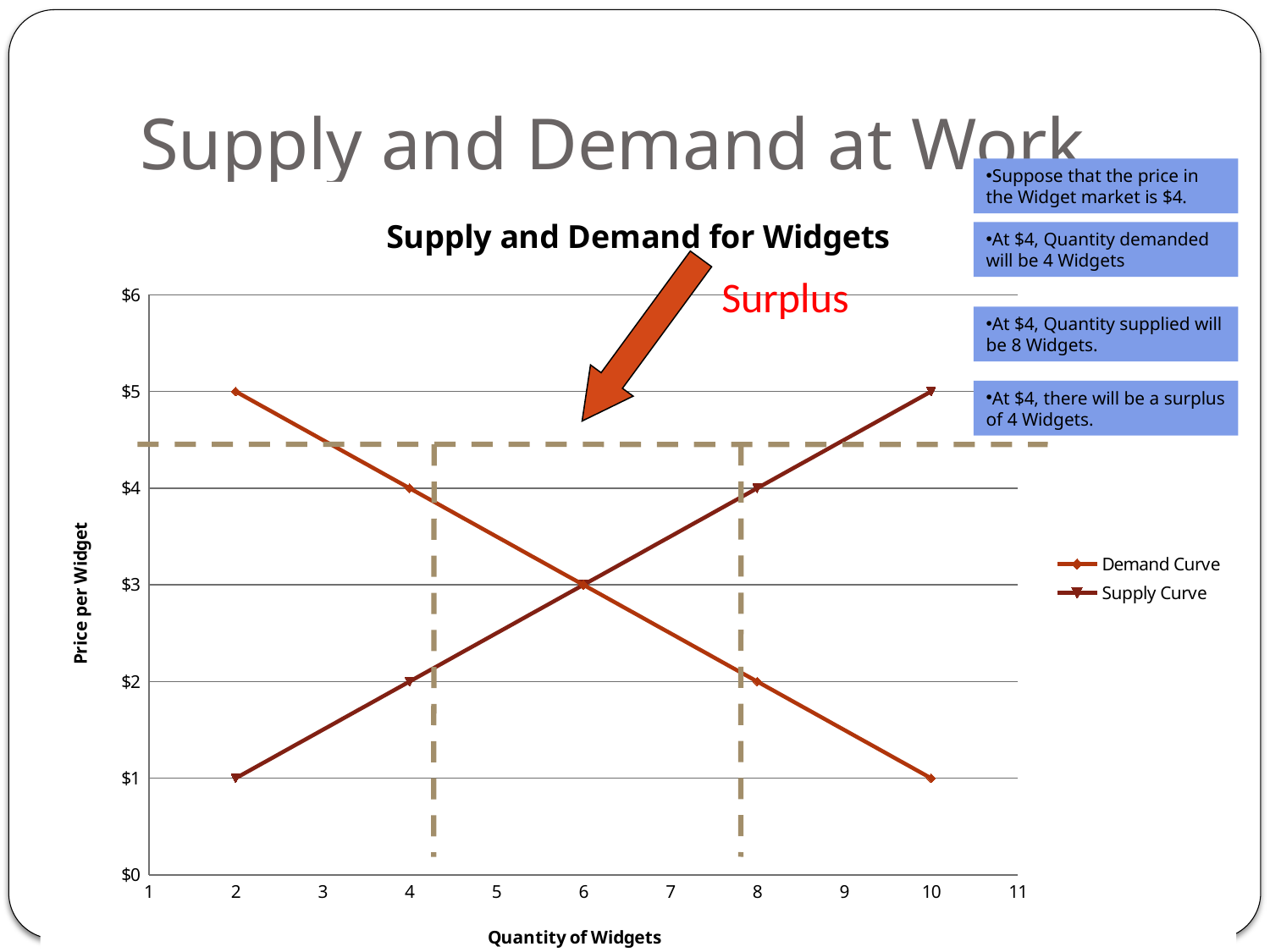
What are the two series named in the legend? Demand Curve and Supply Curve Does the Supply Curve rise or fall as quantity increases along the x axis? rise What type of chart is shown on the slide? line chart At a quantity of 2 widgets, which series has the higher price, the Demand Curve or the Supply Curve? Demand Curve At what quantity do the Demand Curve and Supply Curve intersect? 6 Does the Demand Curve rise or fall as quantity increases along the x axis? fall What is the title of the chart? Supply and Demand for Widgets How many series does the chart legend list? 2 What is the price at which the Demand Curve and Supply Curve intersect? $3 How many data points are plotted on the Demand Curve? 5 What is the price on the Supply Curve at a quantity of 8 widgets? $4 What is the price on the Demand Curve at a quantity of 4 widgets? $4